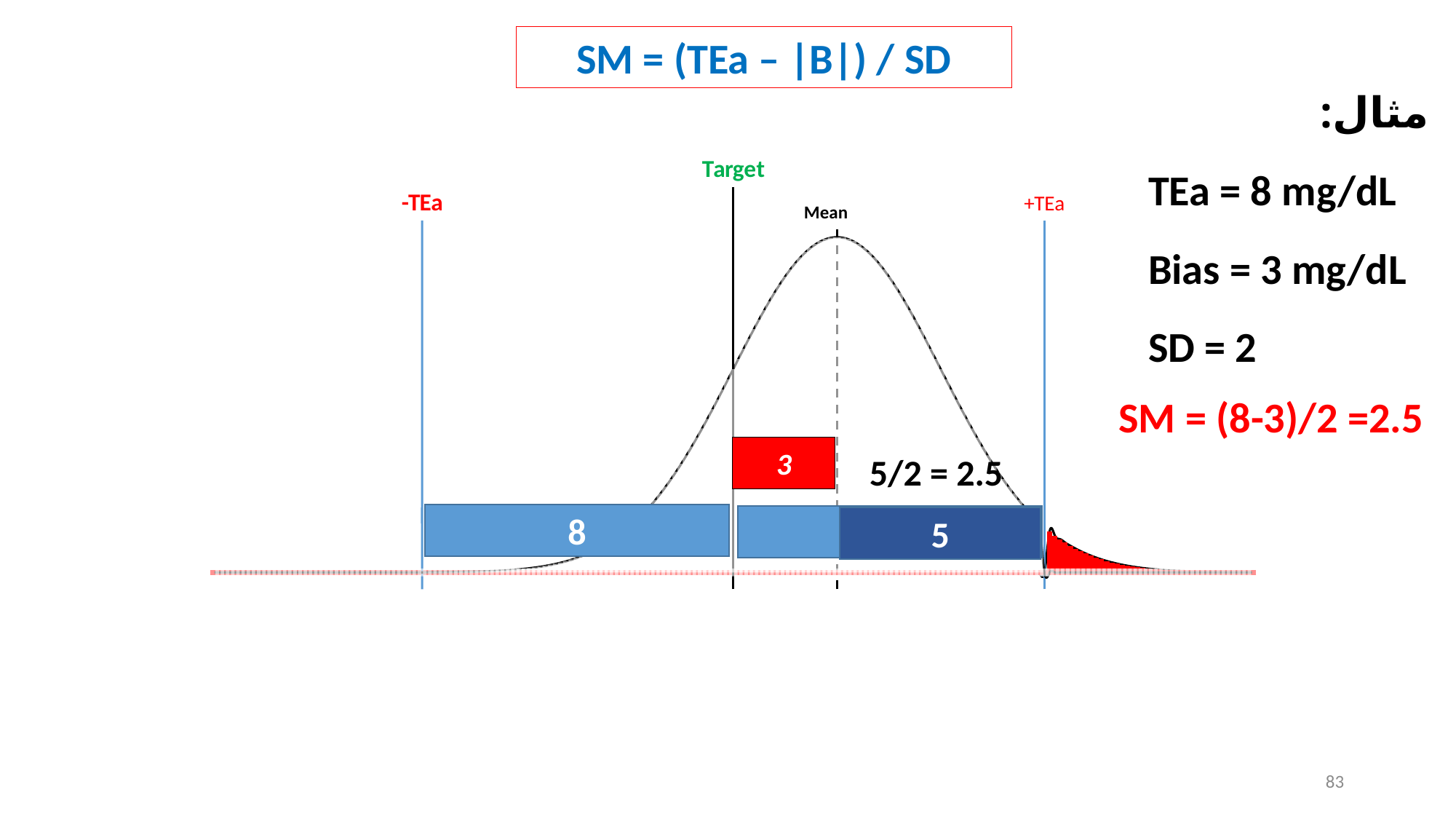
What is the difference between the value in the light blue bar (8) and the value in the red box (3)? 5 What is the final SM value computed on the slide? 2.5 What value is printed inside the dark blue bar on the right of the diagram? 5 What is the TEa value given in the example on the slide? 8 mg/dL What is the Bias value given in the example on the slide? 3 mg/dL What label is written above the dashed vertical line at the peak of the curve? Mean What value is printed inside the red box above the bars? 3 What calculation is written next to the dark blue bar? 5/2 = 2.5 Which is larger, the value in the light blue bar or the value in the dark blue bar? the light blue bar (8) What label is written at the top of the solid black vertical line in the diagram? Target What value is printed inside the light blue bar on the left of the diagram? 8 What is the SD value given in the example on the slide? 2